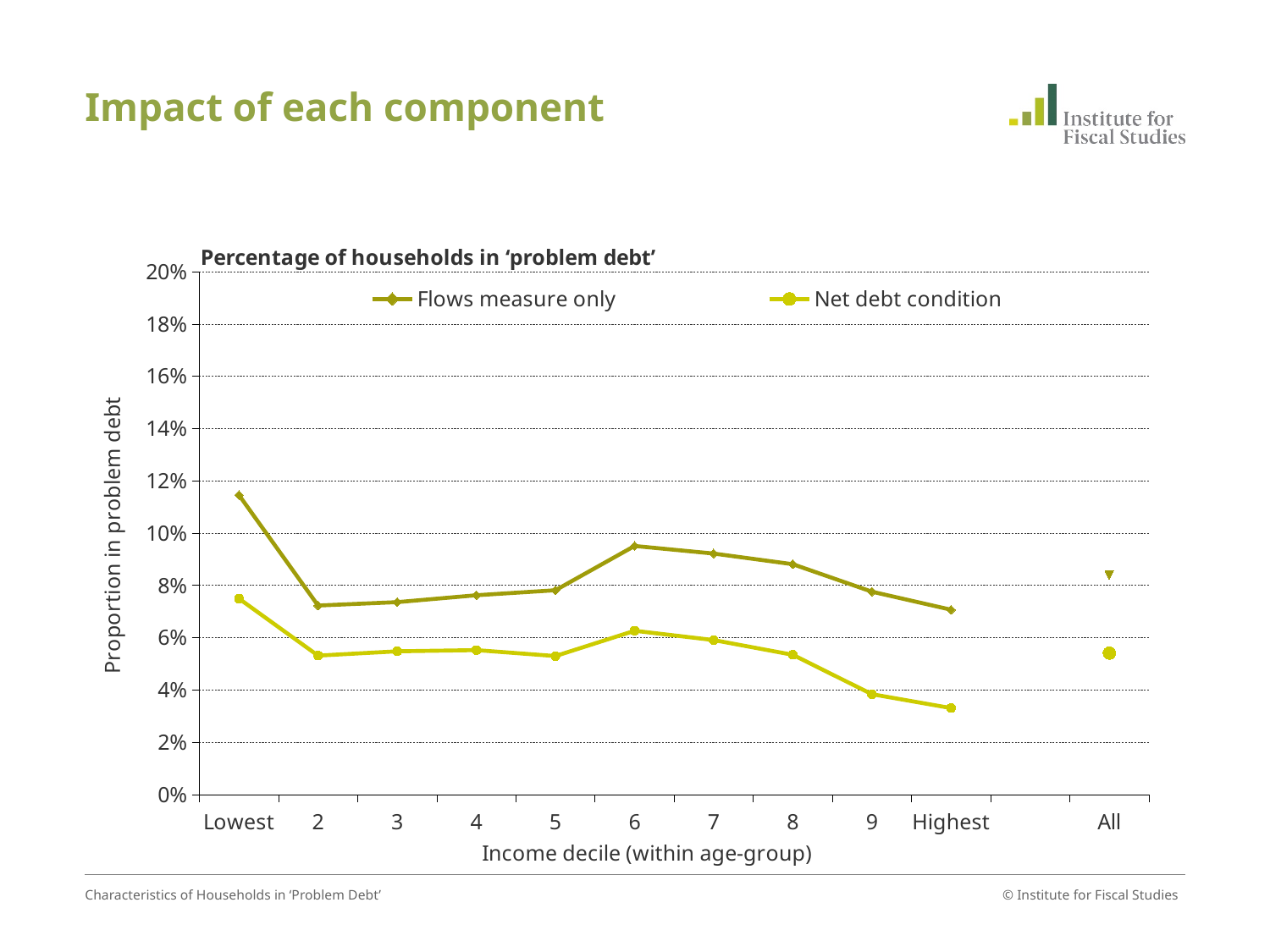
What kind of chart is shown on the slide? line chart Is the 'Flows measure only' value for decile 6 greater or less than 8%? greater What is the title of the chart? Percentage of households in ‘problem debt’ What is the label of the x axis? Income decile (within age-group) Is the 'Flows measure only' value for the Lowest income decile greater or less than 10%? greater How many categories are shown along the x axis? 11 For the 'Net debt condition' series, which income decile has the lowest proportion in problem debt? Highest Which series has the larger value for decile 9: 'Flows measure only' or 'Net debt condition'? Flows measure only How many series does the legend list? 2 Does the 'Net debt condition' series rise or fall from decile 8 to the Highest decile? fall For the 'Flows measure only' series, which income decile has the highest proportion in problem debt? Lowest Is the 'Net debt condition' value for the Highest income decile greater or less than 4%? less